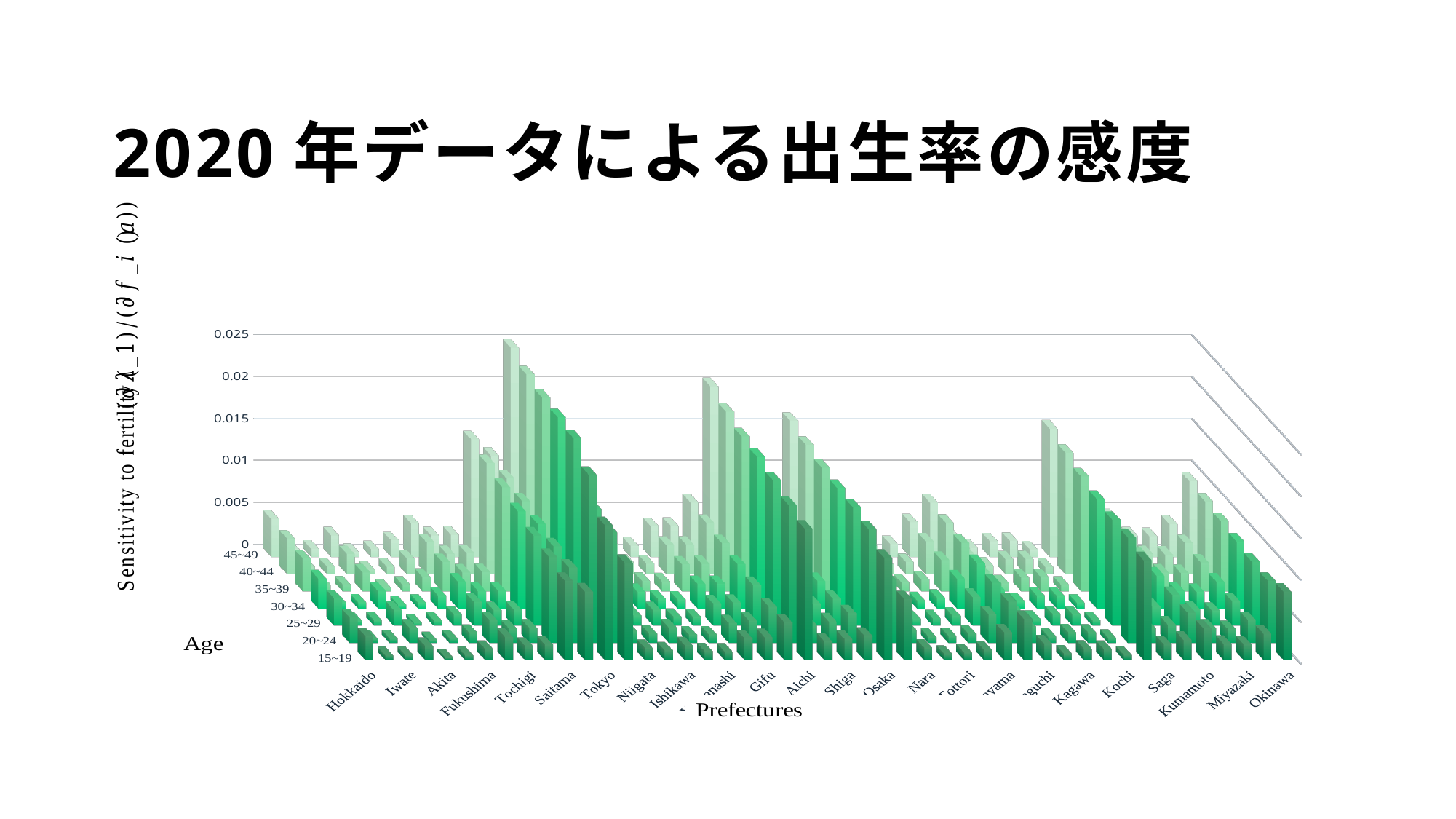
How many age groups are shown on the Age axis of the chart? 7 What is the label of the horizontal axis of the chart? Prefectures What kind of chart is shown on the slide? bar chart What is the highest tick value shown on the vertical axis of the chart? 0.025 Which prefecture is the first category on the Prefectures axis of the chart? Hokkaido Which age group is listed last (back) on the Age axis of the chart? 45~49 Which age group is listed first (front) on the Age axis of the chart? 15~19 Which prefecture is the last category on the Prefectures axis of the chart? Okinawa